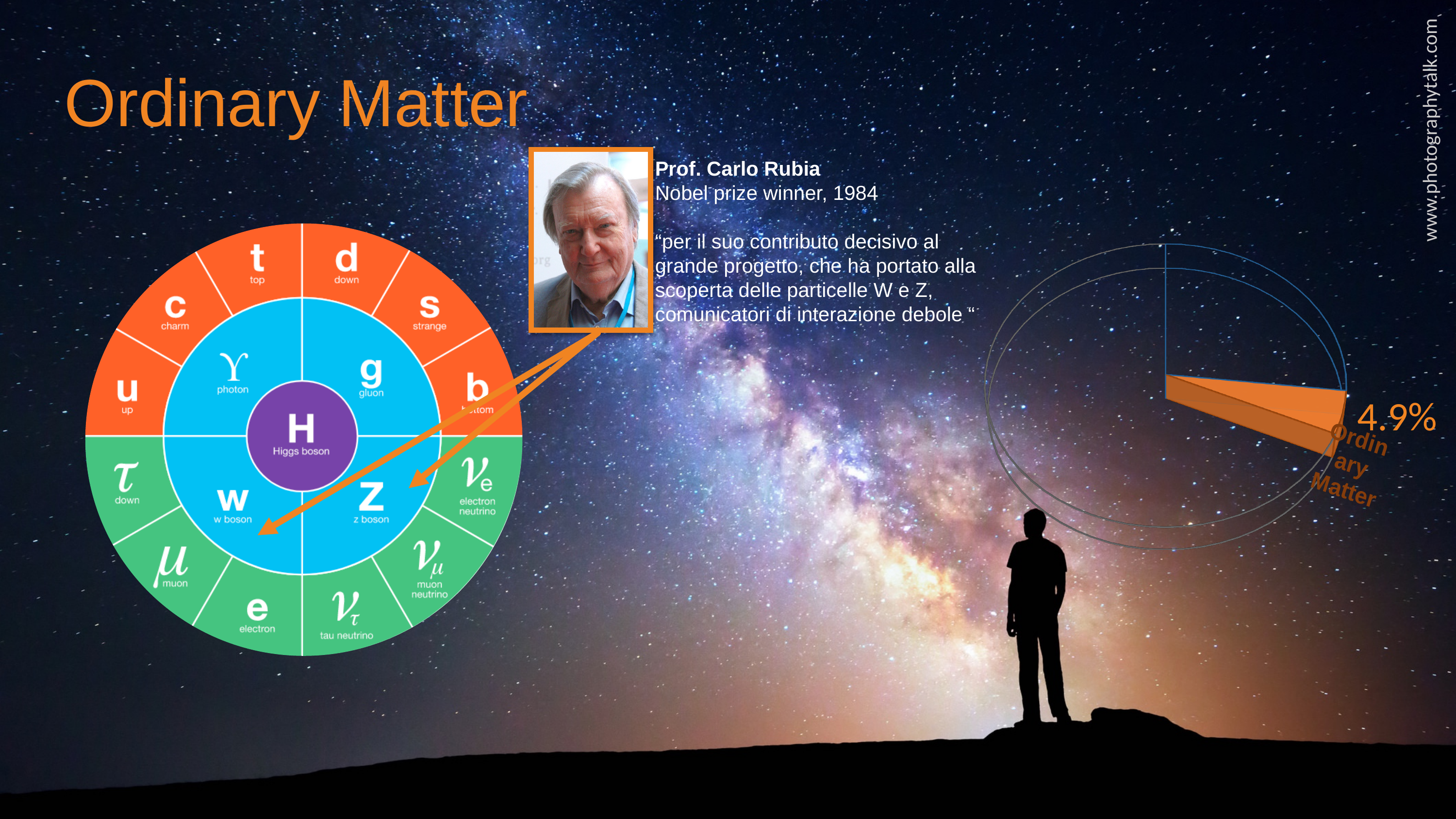
What kind of chart is shown on the right side of the slide? pie chart In the pie chart on the right, what share of the pie does the Ordinary Matter slice represent? 4.9% In the pie chart on the right, is the Ordinary Matter slice larger or smaller than the remaining unlabeled portion of the pie? smaller In the pie chart on the right, what is the label of the orange slice? Ordinary Matter In the pie chart on the right, what is the value printed next to the orange slice? 4.9% In the pie chart on the right, what colour is the Ordinary Matter slice? orange In the pie chart on the right, is the Ordinary Matter slice greater or less than 10% of the pie? less